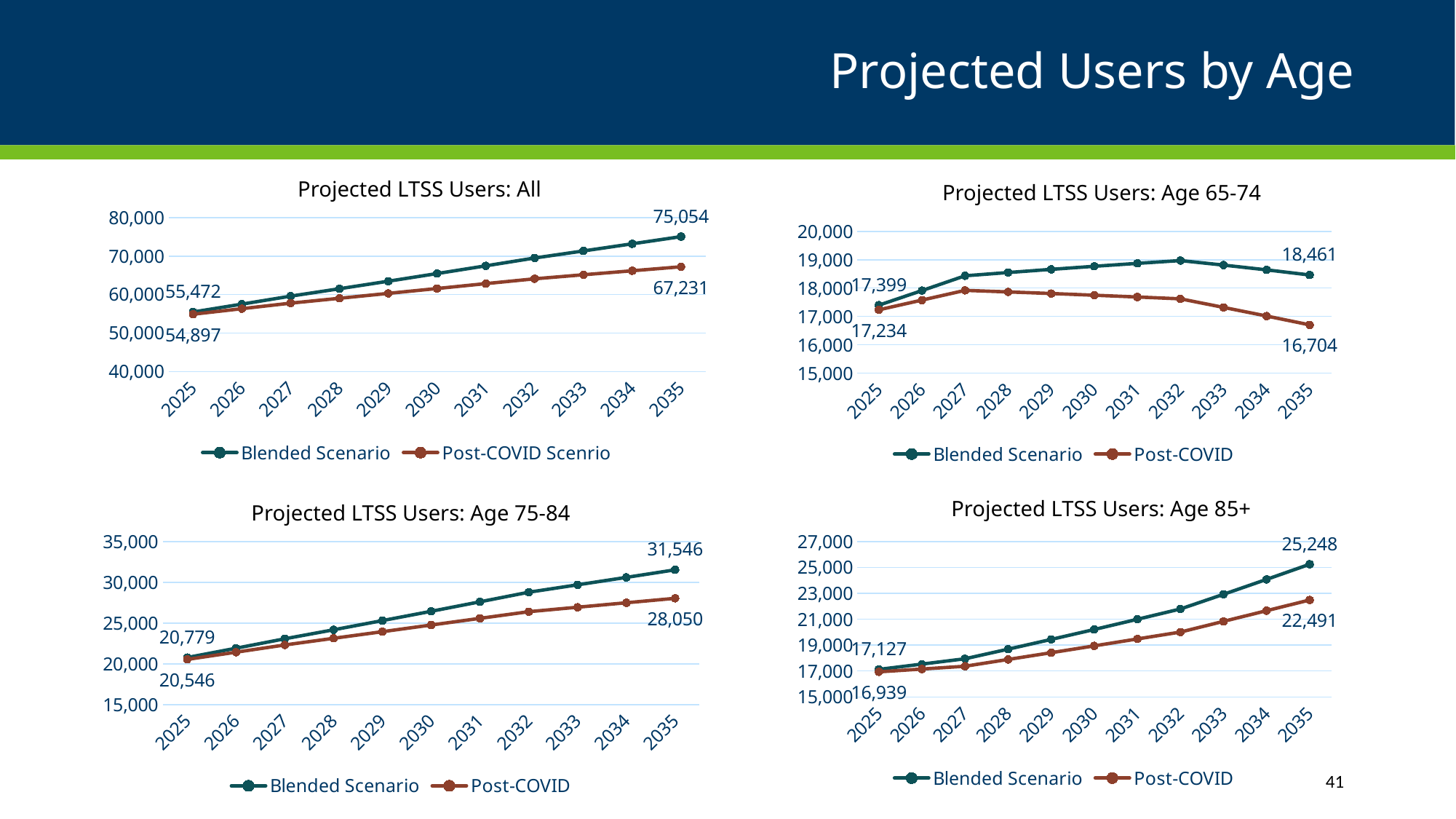
What kind of chart is 'Projected LTSS Users: Age 85+'? line chart How many years are shown on the x axis of the 'Projected LTSS Users: All' chart? 11 In the 'Projected LTSS Users: Age 85+' chart, which series has the higher value in 2035, Blended Scenario or Post-COVID? Blended Scenario In the 'Projected LTSS Users: Age 85+' chart, what is the Post-COVID value for 2035? 22,491 In the 'Projected LTSS Users: All' chart, what is the Post-COVID Scenrio value for 2025? 54,897 In the 'Projected LTSS Users: All' chart, what is the difference between the Blended Scenario and Post-COVID Scenrio values in 2035? 7,823 In the 'Projected LTSS Users: All' chart, what is the Blended Scenario value for 2035? 75,054 In the 'Projected LTSS Users: Age 75-84' chart, what is the Blended Scenario value for 2025? 20,779 In the 'Projected LTSS Users: Age 75-84' chart, what is the difference between the Blended Scenario and Post-COVID values in 2035? 3,496 In the 'Projected LTSS Users: Age 75-84' chart, is the Blended Scenario value for 2032 greater or less than 30,000? less In the 'Projected LTSS Users: Age 65-74' chart, does the Post-COVID line rise or fall from 2025 to 2035? fall In the 'Projected LTSS Users: Age 65-74' chart, what is the Post-COVID value for 2035? 16,704